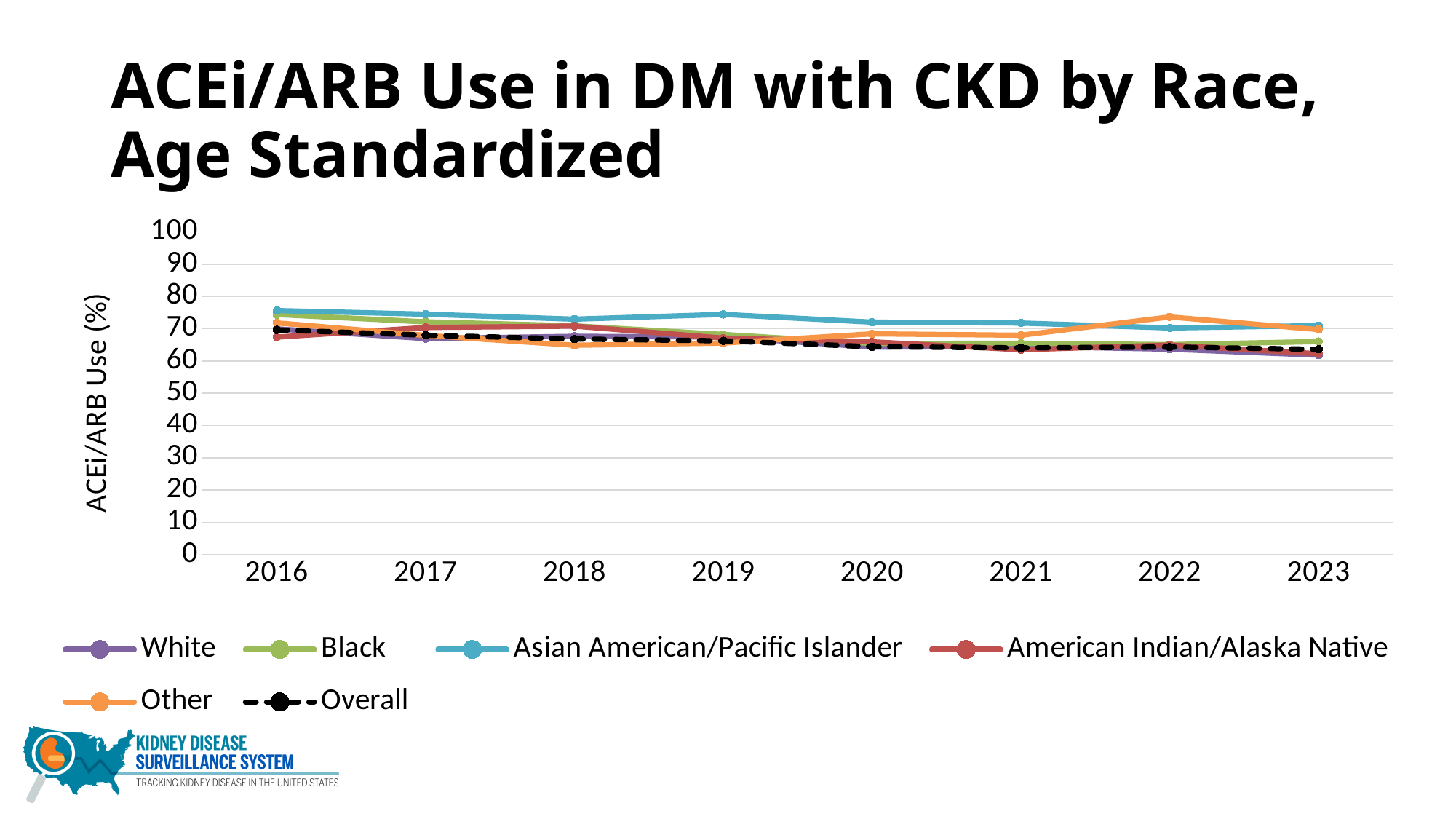
In 2016, which is larger: the value for Asian American/Pacific Islander or for American Indian/Alaska Native? Asian American/Pacific Islander What kind of chart is shown on the slide? Line chart How many series does the legend list? 6 Is the value for Asian American/Pacific Islander in 2019 greater or less than 70? greater Is the value for Other in 2022 greater or less than 70? greater Which series is drawn as a dashed black line? Overall What is the title of the chart? ACEi/ARB Use in DM with CKD by Race, Age Standardized How many years are plotted along the x axis? 8 Which series has the highest value in 2022? Other Which series has the highest value in 2019? Asian American/Pacific Islander Does the Overall series rise or fall from 2016 to 2023? Fall Is the value for Overall in 2023 greater or less than 70? less